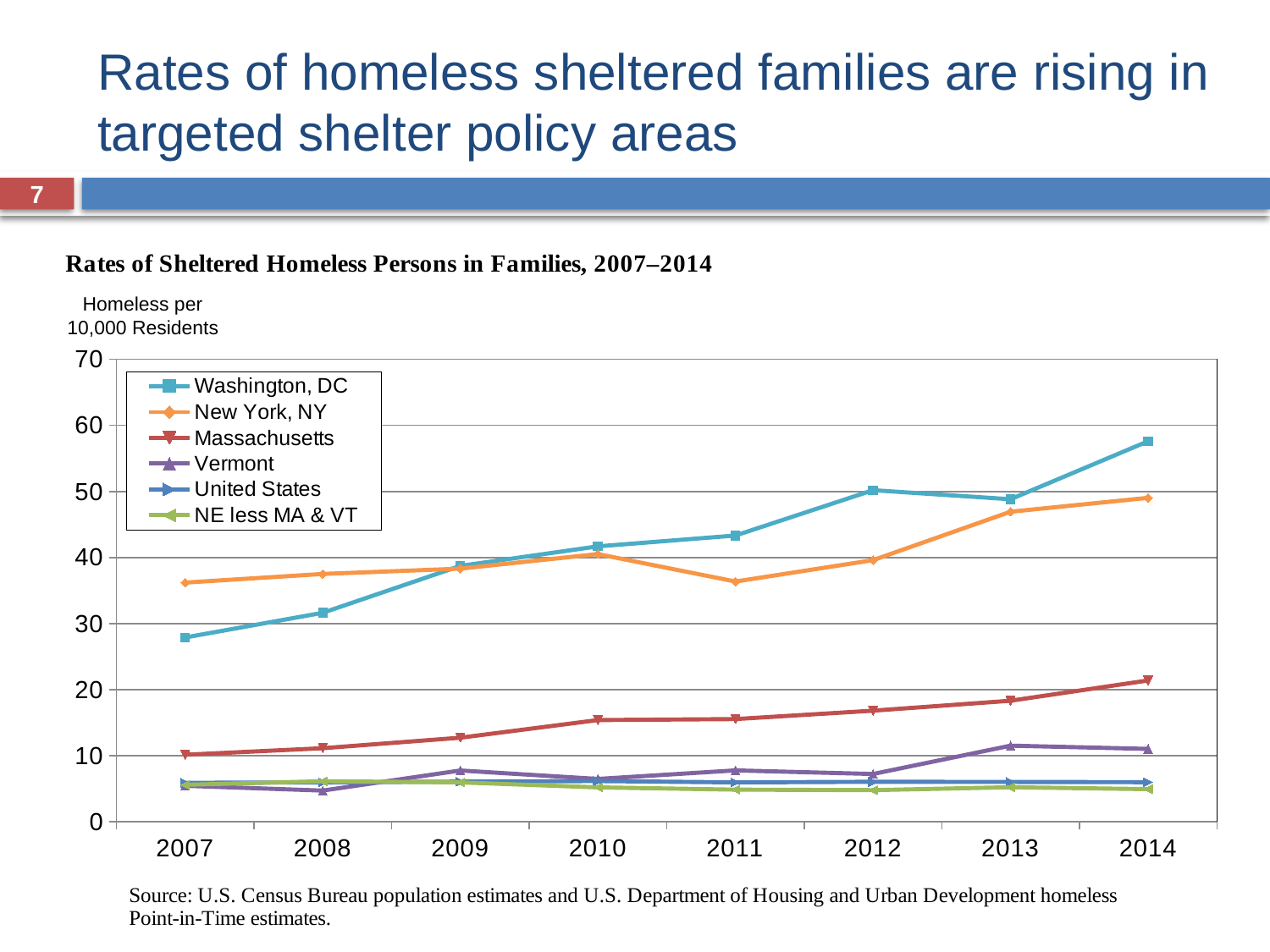
Which series has the highest value in 2014? Washington, DC What kind of chart is shown on the slide? line chart How many series does the legend list? 6 Is the value for Washington, DC in 2014 greater or less than 50? greater In 2007, which is larger: the value for Washington, DC or the value for New York, NY? New York, NY Is the value for Massachusetts in 2014 greater or less than 20? greater What is the title of the chart? Rates of Sheltered Homeless Persons in Families, 2007–2014 How many years are plotted along the x axis? 8 In 2014, which is larger: the value for Massachusetts or the value for Vermont? Massachusetts Does the Massachusetts line rise or fall from 2007 to 2014? rise Is the value for Washington, DC in 2007 greater or less than 30? less